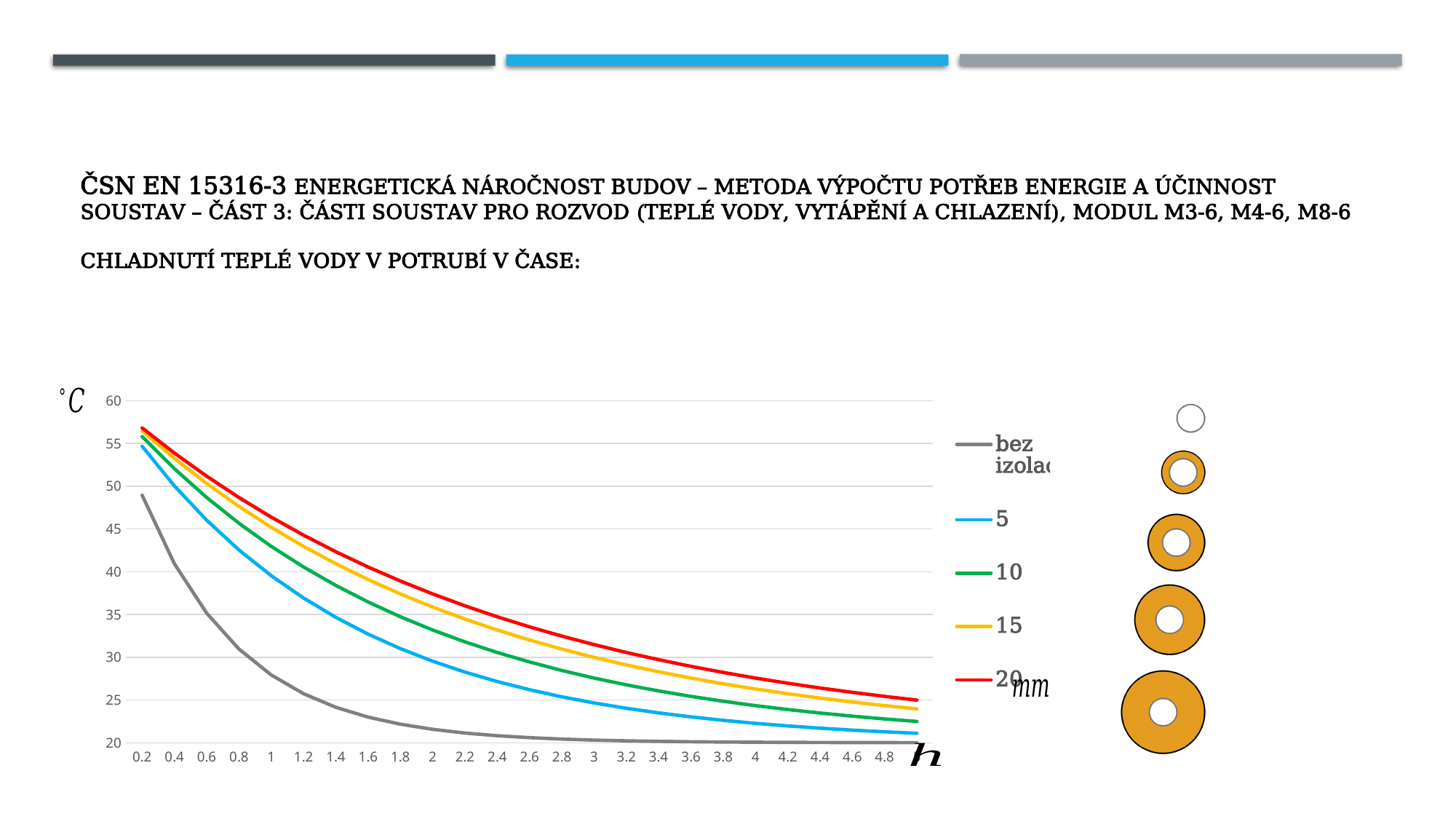
What kind of chart is shown on the slide? line chart Which series has the highest temperature at 4.8 h? 20 Is the value for the 5 series at 4.8 h greater or less than 25? less Is the value for bez izolace at 0.2 h greater or less than 45? greater How many series does the legend list? 5 Which series has the lowest temperature at 0.2 h? bez izolace Is the value for the 20 series at 3 h greater or less than 30? greater What colour is the line for the 15 series? yellow At 1 h, which series has the higher temperature: 20 or bez izolace? 20 Do the temperature values rise or fall as time (h) increases along the x axis? fall What unit is shown on the y axis of the chart? °C